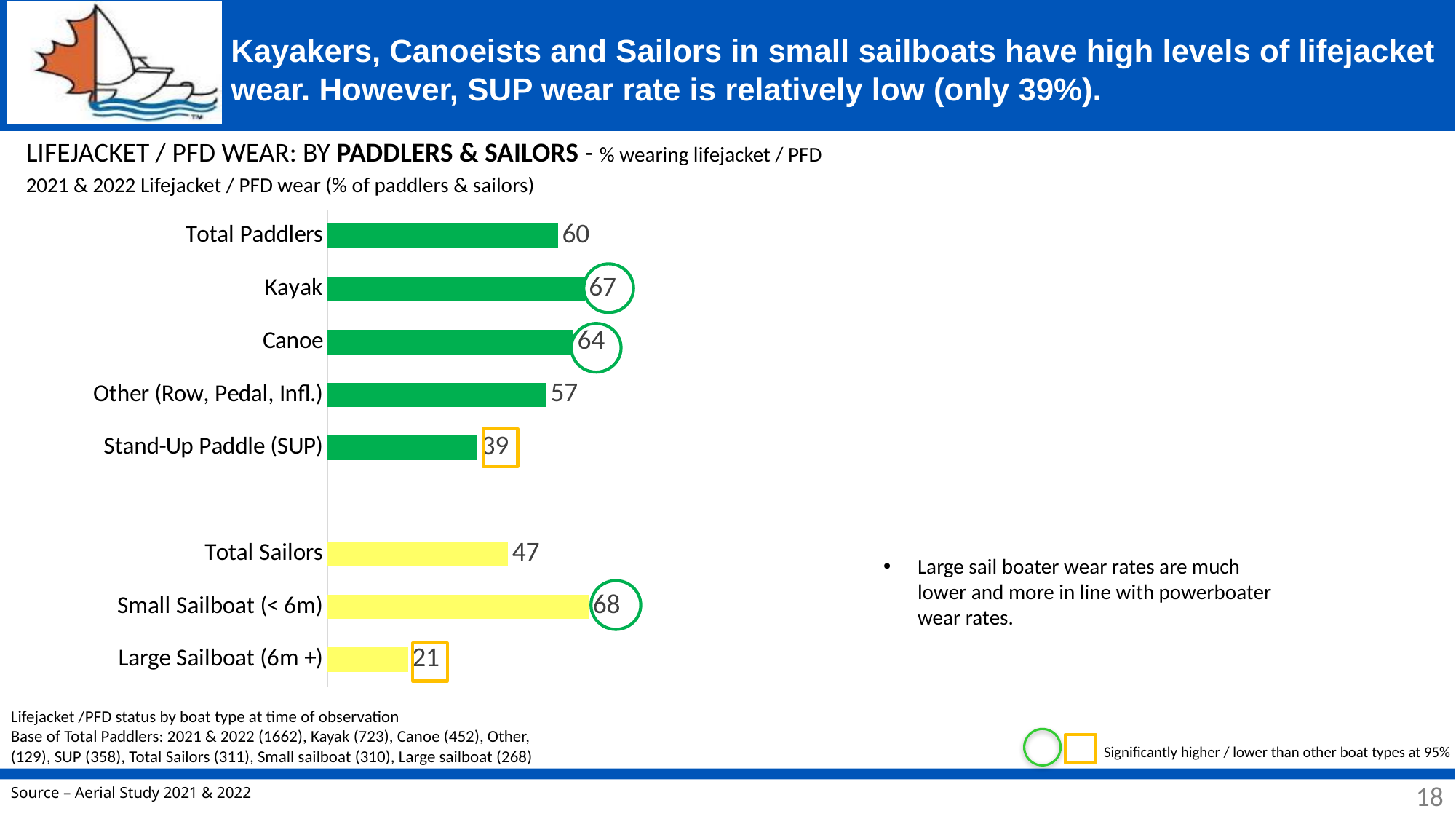
What is the difference between the Kayak value and the Stand-Up Paddle (SUP) value? 28 How many categories are plotted in the chart? 8 Which is larger, the value for Canoe or the value for Other (Row, Pedal, Infl.)? Canoe What kind of chart is shown on the slide? Bar chart What colour are the bars for the sailor categories? Yellow What is the lifejacket / PFD wear value for Stand-Up Paddle (SUP)? 39 Which category has the highest lifejacket / PFD wear value? Small Sailboat (< 6m) What is the lifejacket / PFD wear value for Large Sailboat (6m +)? 21 Which category has the lowest lifejacket / PFD wear value? Large Sailboat (6m +) What is the lifejacket / PFD wear value for Kayak? 67 What is the lifejacket / PFD wear value for Total Sailors? 47 What is the difference between the Small Sailboat (< 6m) value and the Large Sailboat (6m +) value? 47